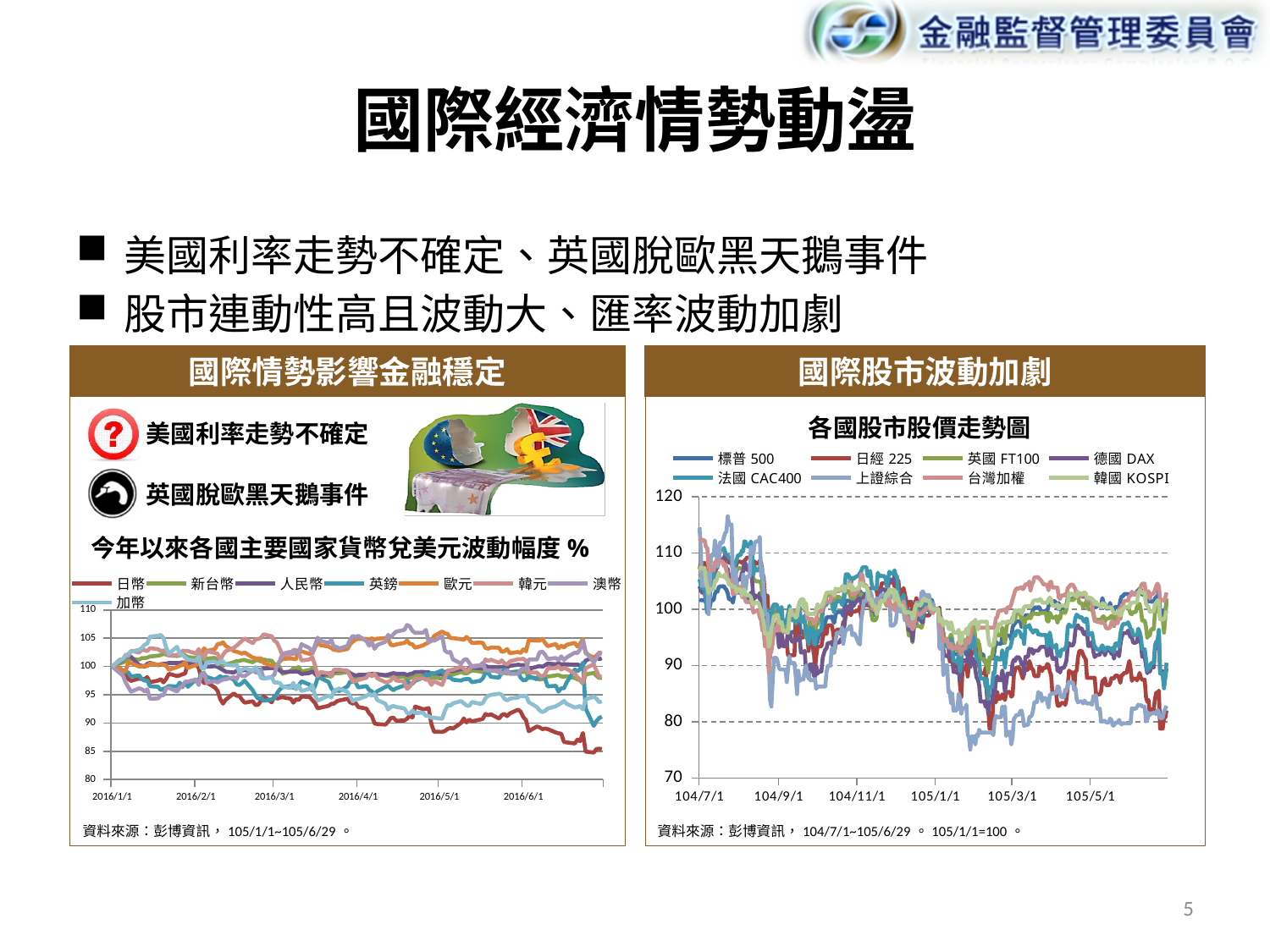
In the left chart (今年以來各國主要國家貨幣兌美元波動幅度 %), is the value for 日幣 at the end of the period greater or less than 90? less In the right chart (各國股市股價走勢圖), is the value for 日經 225 at the end of the period greater or less than 90? less What kind of chart is the chart titled 各國股市股價走勢圖 on the right? line chart What kind of chart is the chart titled 今年以來各國主要國家貨幣兌美元波動幅度 % on the left? line chart In the right chart (各國股市股價走勢圖), does the 上證綜合 line rise or fall overall from 104/7/1 to the end of the period? fall In the left chart (今年以來各國主要國家貨幣兌美元波動幅度 %), does the 日幣 line rise or fall overall from 2016/1/1 to the end of the period? fall In the right chart (各國股市股價走勢圖), is the lowest value reached by 上證綜合 greater or less than 80? less What is the title of the chart on the right side of the slide? 各國股市股價走勢圖 How many series does the legend of the left chart (今年以來各國主要國家貨幣兌美元波動幅度 %) list? 8 How many series does the legend of the right chart (各國股市股價走勢圖) list? 8 How many date labels are shown on the x axis of the right chart (各國股市股價走勢圖)? 6 In the right chart (各國股市股價走勢圖), what is the highest value shown on the y axis? 120